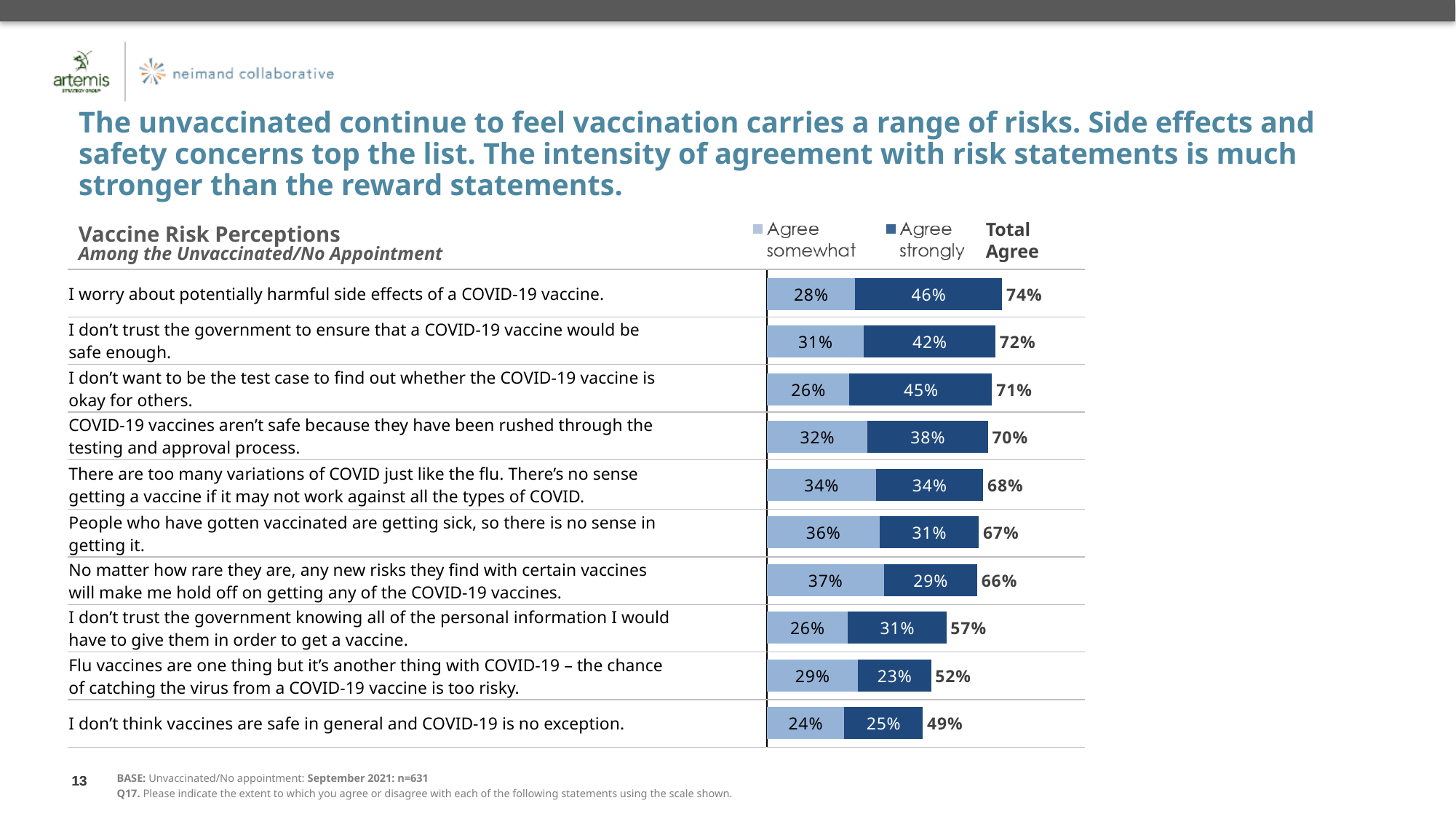
What percentage of the unvaccinated agree strongly that they worry about potentially harmful side effects of a COVID-19 vaccine? 46% Which statement has the highest Total Agree? I worry about potentially harmful side effects of a COVID-19 vaccine. What is the Total Agree for the statement 'I don't think vaccines are safe in general and COVID-19 is no exception'? 49% What is the 'Agree somewhat' value for the statement 'COVID-19 vaccines aren't safe because they have been rushed through the testing and approval process'? 32% Which is larger: the 'Agree strongly' share for 'I don't want to be the test case' or for 'People who have gotten vaccinated are getting sick'? I don't want to be the test case How many statements are shown in the Vaccine Risk Perceptions chart? 10 What is the total of the stacked bar for 'There are too many variations of COVID just like the flu'? 68% What type of chart is used to show the Vaccine Risk Perceptions data? Stacked bar chart How many series does the legend list? 2 Which statement has the lowest Total Agree? I don't think vaccines are safe in general and COVID-19 is no exception. What is the difference in Total Agree between the side effects statement (74%) and the flu vaccine statement (52%)? 22% What is the subtitle of the Vaccine Risk Perceptions chart? Among the Unvaccinated/No Appointment